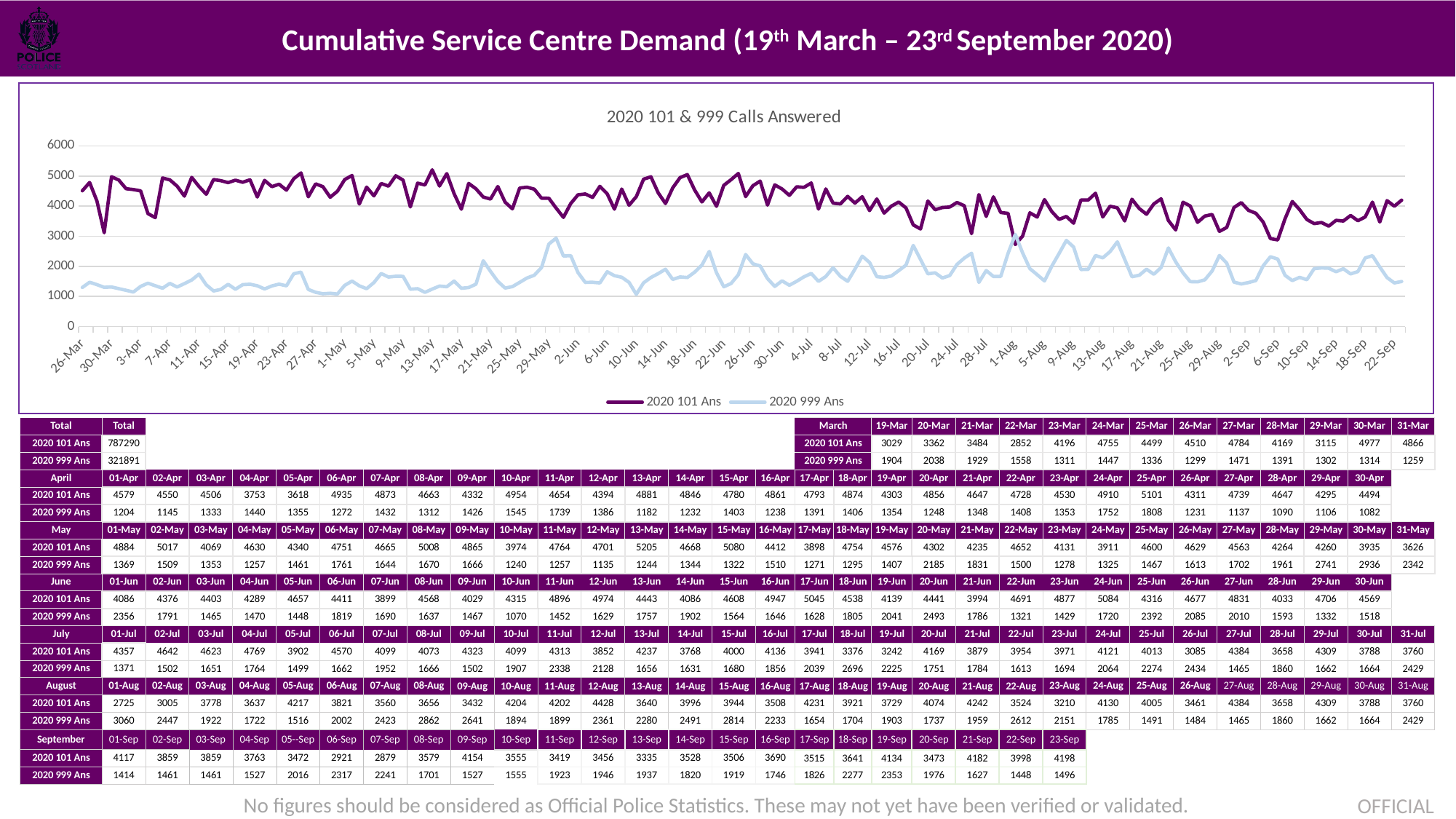
Is the value for 2020 101 Ans on 26-Mar greater or less than 4000? greater What kind of chart is shown on the slide? line chart What is the difference between the total 2020 101 Ans and the total 2020 999 Ans? 465399 What is the value for 2020 999 Ans on 23-Sep? 1496 How many series does the chart legend list? 2 What is the value for 2020 101 Ans on 19-Mar? 3029 Does the 2020 101 Ans line generally rise or fall from March to September? fall What is the title of the chart? 2020 101 & 999 Calls Answered On 19-Mar, which is larger: 2020 101 Ans or 2020 999 Ans? 2020 101 Ans What are the two legend entries of the chart? 2020 101 Ans and 2020 999 Ans What is the total for 2020 999 Ans shown in the table? 321891 What is the total for 2020 101 Ans shown in the table? 787290